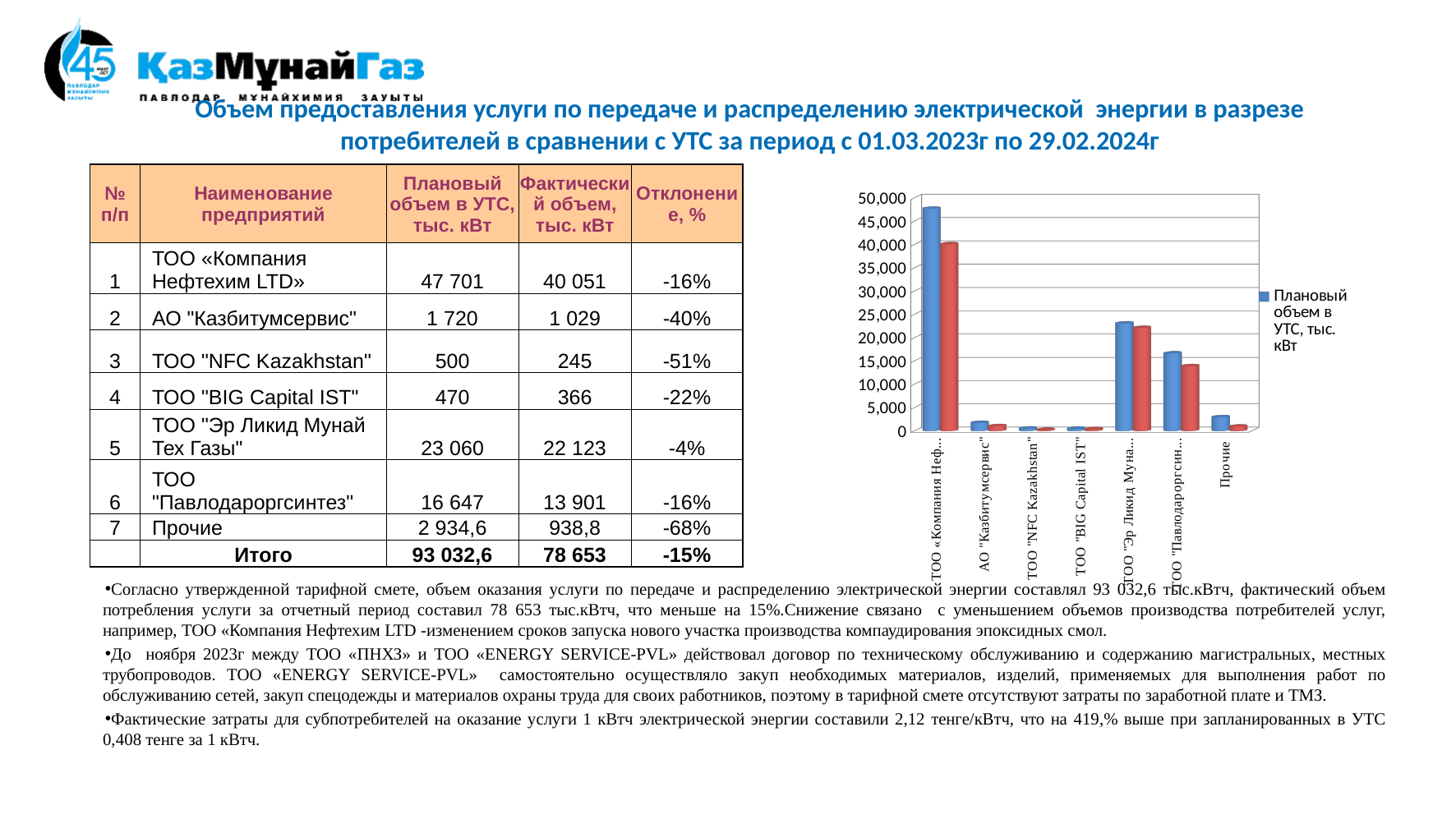
How many enterprise categories are shown on the x axis of the chart? 7 Which category has the tallest bar in the chart? ТОО «Компания Нефтехим LTD» Is the blue (planned) bar for ТОО «Компания Нефтехим LTD» greater or less than 45,000? greater Which has the taller blue (planned) bar: ТОО "Эр Ликид Мунай Тех Газы" or ТОО "Павлодароргсинтез"? ТОО "Эр Ликид Мунай Тех Газы" Is the blue (planned) bar for ТОО "Эр Ликид Мунай Тех Газы" greater or less than 20,000? greater What kind of chart is shown on the slide? bar chart Using the table values on the slide, what is the difference between the planned and actual volume for ТОО «Компания Нефтехим LTD»? 7 650 Is the blue (planned) bar for Прочие greater or less than 5,000? less What legend entry is shown next to the chart? Плановый объем в УТС, тыс. кВт For ТОО «Компания Нефтехим LTD», which bar is taller: the blue (planned) or the red (actual)? blue (planned) According to the table on the slide, what is the planned volume (Плановый объем в УТС) for ТОО «Компания Нефтехим LTD» plotted in the chart? 47 701